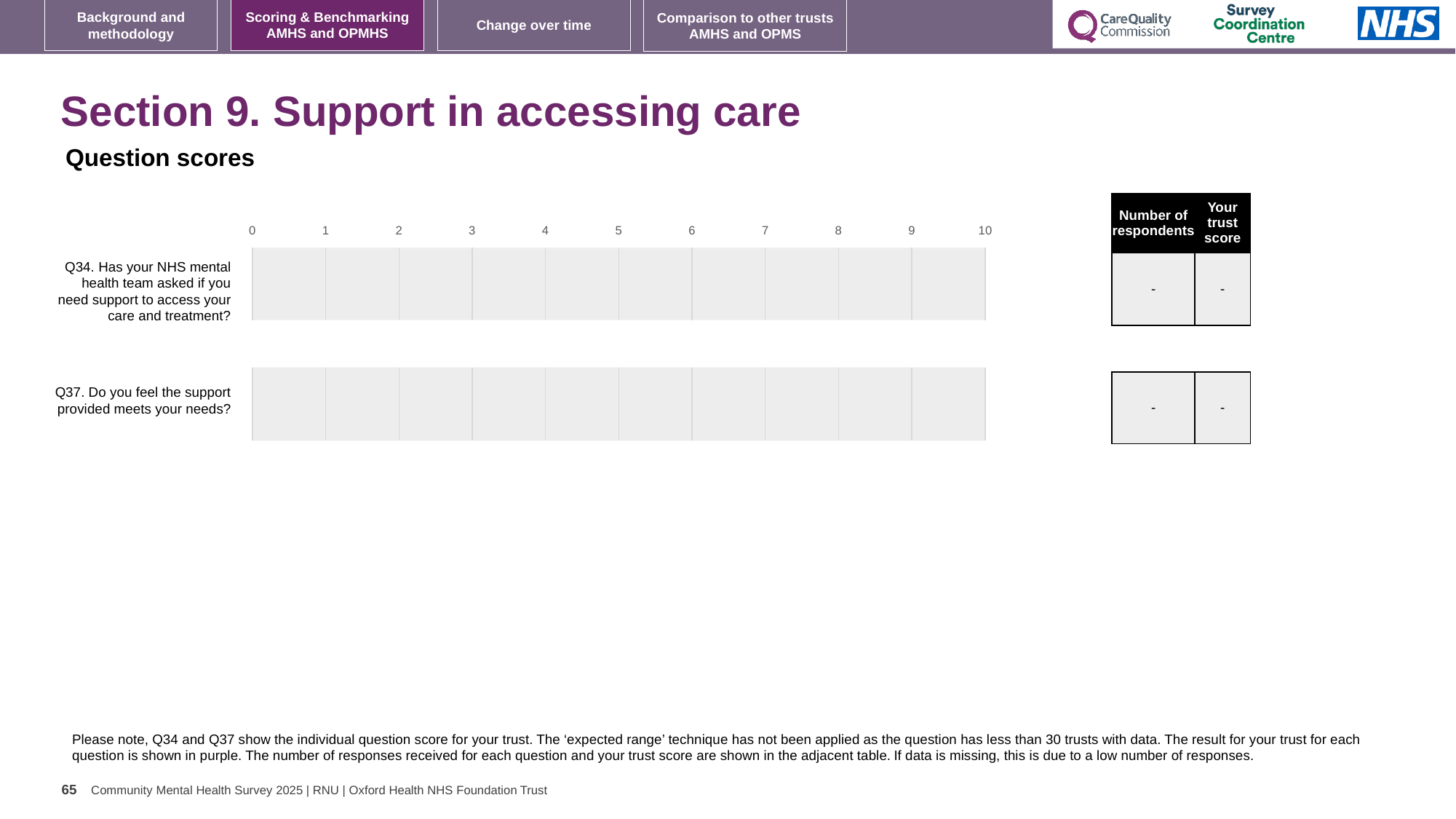
How many questions are listed as categories on the chart? 2 What kind of chart is used to show the question scores? bar chart What is shown in the 'Your trust score' column for Q34 in the table next to the chart? - What is the heading shown above the chart? Question scores What is the highest value shown on the chart's x axis? 10 What is shown in the 'Number of respondents' column for Q37 in the table next to the chart? -